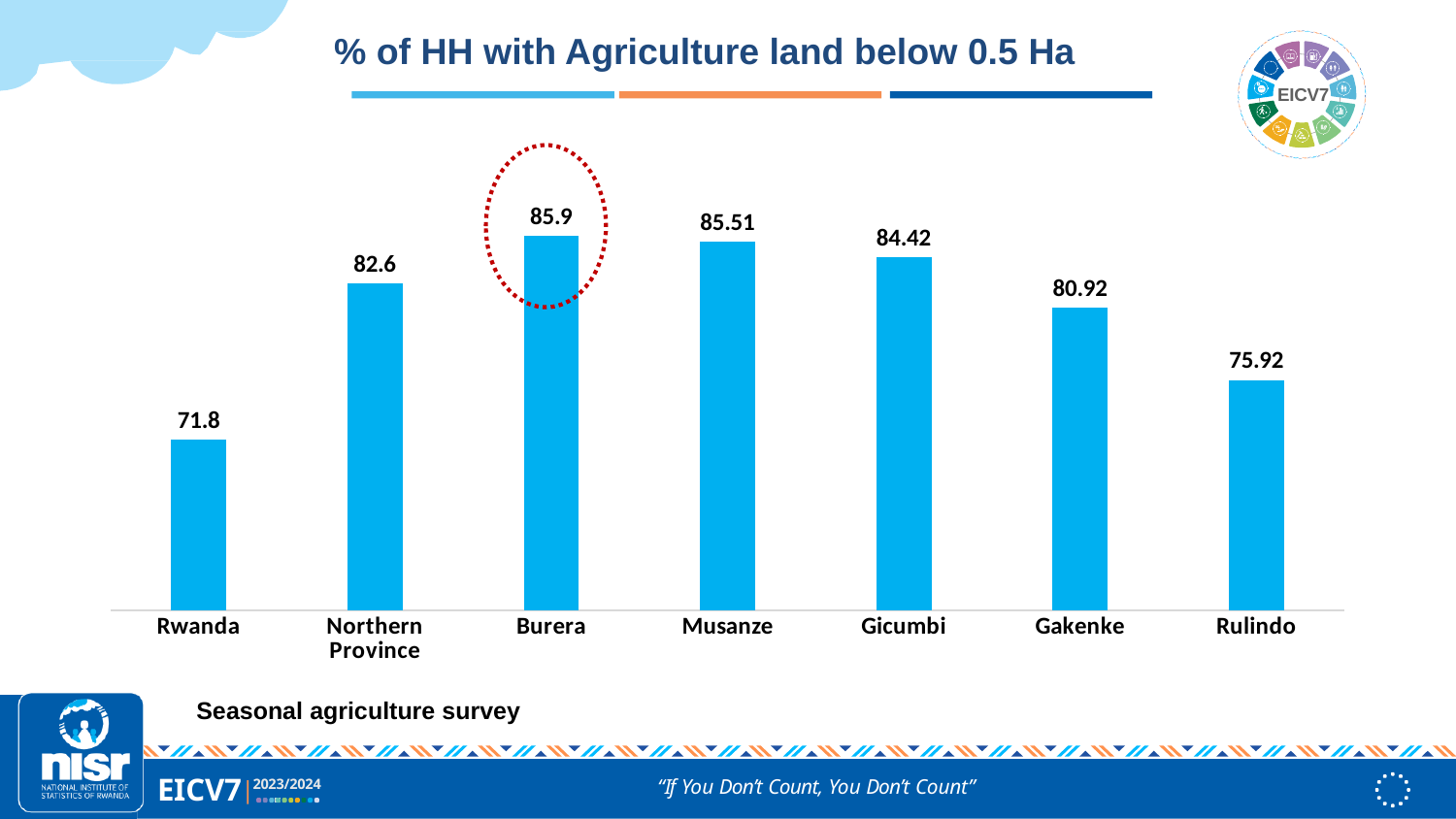
Which is larger, the value for Musanze or the value for Rulindo? Musanze What is the value for Rwanda? 71.8 Which category has the lowest value? Rwanda Which category has the highest value? Burera What kind of chart is shown on the slide? Bar chart How many categories are shown on the x axis? 7 Do the values rise or fall along the x axis from Burera to Rulindo? Fall What is the value for Northern Province? 82.6 What is the value for Burera? 85.9 What is the value for Gakenke? 80.92 What is the difference between the values for Burera and Rwanda? 14.1 What is the difference between the values for Gicumbi and Gakenke? 3.5